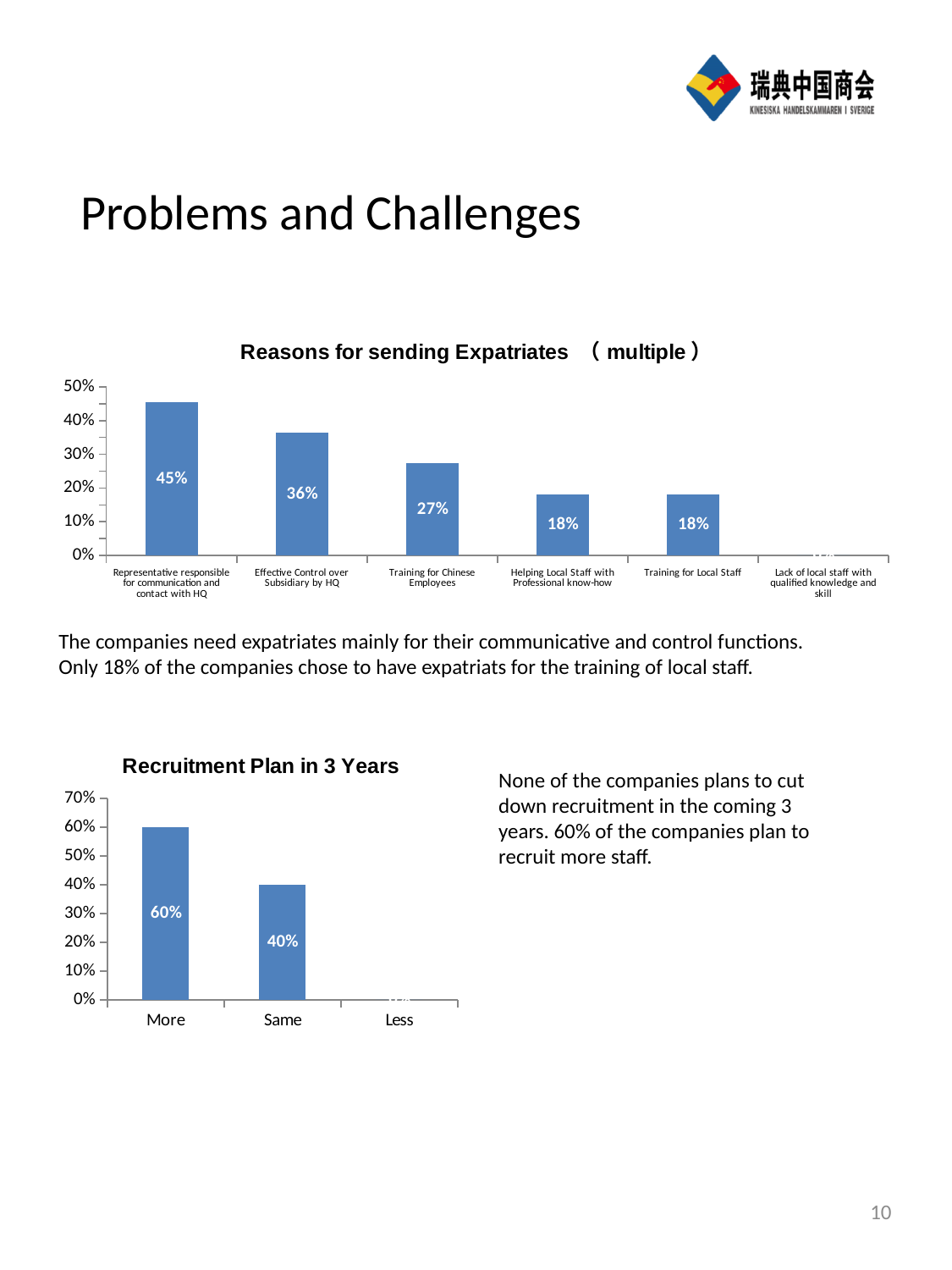
In the 'Recruitment Plan in 3 Years' chart, what is the difference between 'More' and 'Same'? 20% In the 'Reasons for sending Expatriates' chart, which category has the highest value? Representative responsible for communication and contact with HQ In the 'Recruitment Plan in 3 Years' chart, how many categories are shown on the x axis? 3 In the 'Reasons for sending Expatriates' chart, what is the value for 'Effective Control over Subsidiary by HQ'? 36% What kind of chart is 'Reasons for sending Expatriates'? Bar chart In the 'Reasons for sending Expatriates' chart, what is the difference between 'Representative responsible for communication and contact with HQ' and 'Effective Control over Subsidiary by HQ'? 9% In the 'Recruitment Plan in 3 Years' chart, what is the value for 'Same'? 40% In the 'Reasons for sending Expatriates' chart, do the values rise or fall from left to right? Fall In the 'Reasons for sending Expatriates' chart, what is the value for 'Training for Chinese Employees'? 27% In the 'Reasons for sending Expatriates' chart, how many categories are shown on the x axis? 6 In the 'Reasons for sending Expatriates' chart, which is larger: 'Training for Chinese Employees' or 'Helping Local Staff with Professional know-how'? Training for Chinese Employees In the 'Recruitment Plan in 3 Years' chart, what is the value for 'More'? 60%